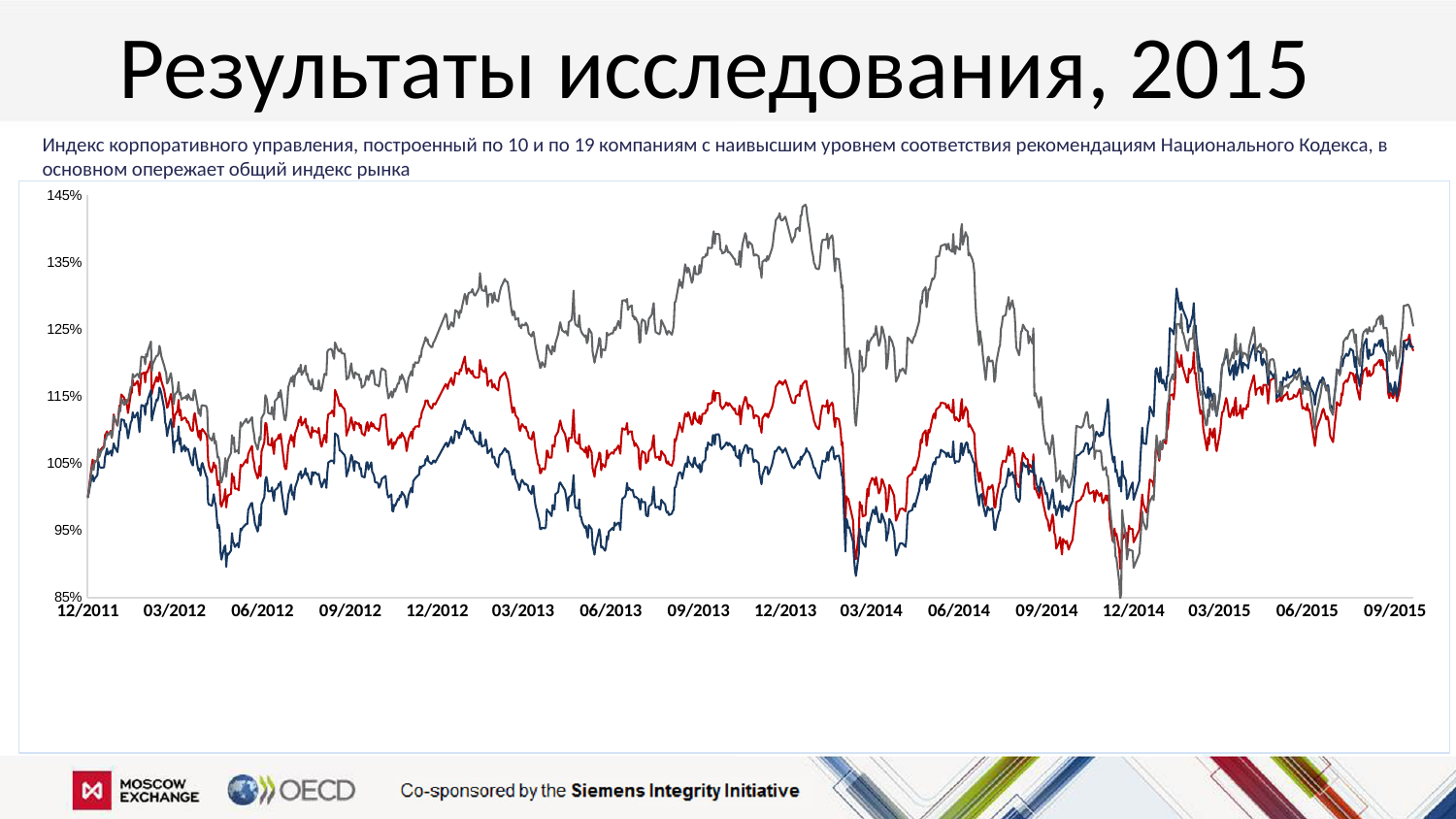
Is the value of the grey line at 12/2013 greater or less than 135%? greater What is the first date label on the x axis? 12/2011 How many lines are plotted on the chart? 3 What is the last date label on the x axis? 09/2015 Does the grey line rise or fall overall between 12/2011 and 12/2013? rise Does the dark blue line rise or fall between 12/2013 and 03/2014? fall How many date labels are shown along the x axis? 16 Is the value of the red line at 12/2012 greater or less than 105%? greater What kind of chart is shown on the slide? line chart Which line reaches the highest value on the chart? the grey line